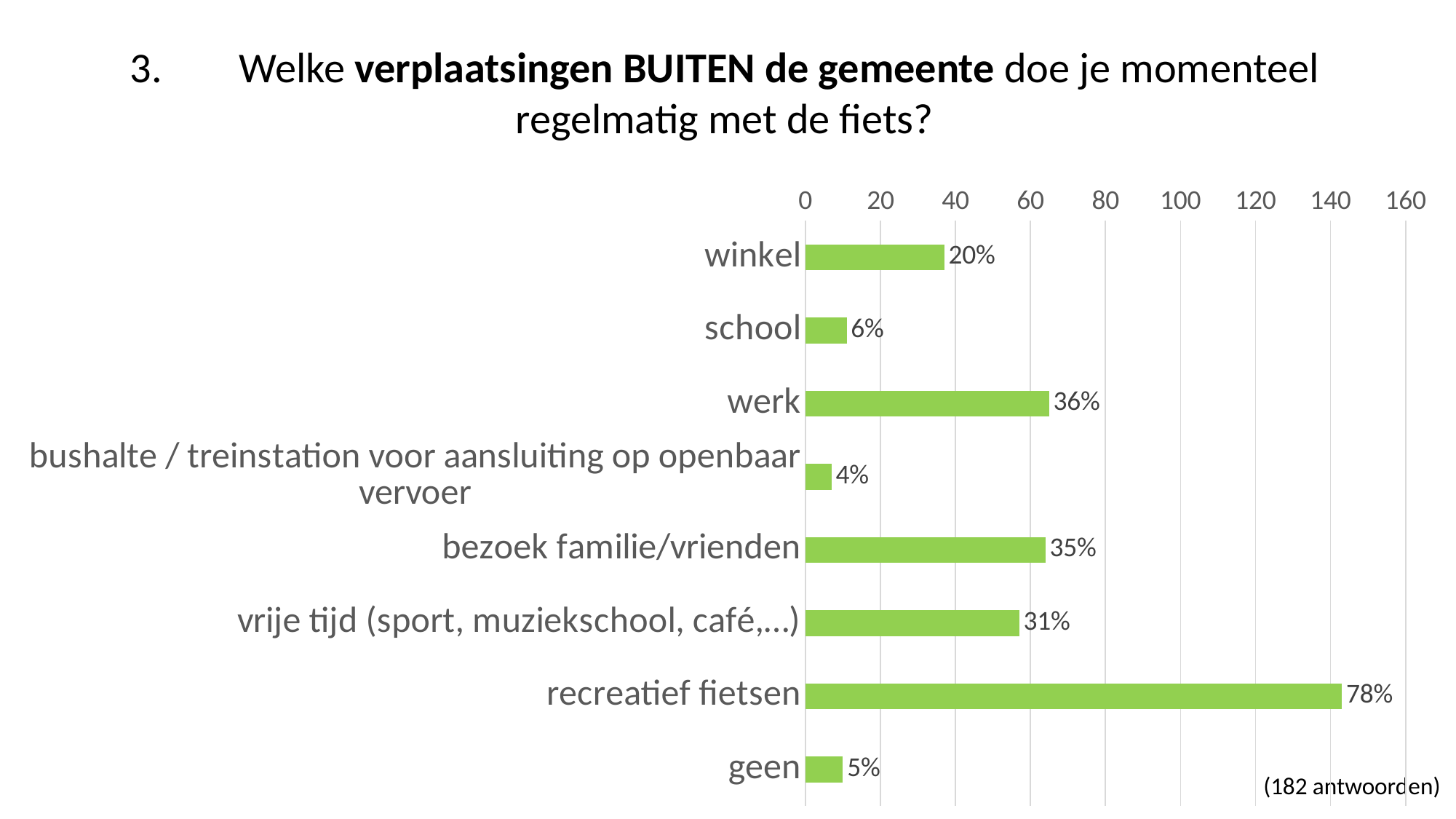
What is the data label for 'school'? 6% How many categories are shown in the chart? 8 Which category has the lowest value? bushalte / treinstation voor aansluiting op openbaar vervoer Is the bar for 'werk' greater or less than 60 on the axis? greater What is the data label for 'werk'? 36% What is the data label for 'recreatief fietsen'? 78% What is the data label for 'bezoek familie/vrienden'? 35% What is the difference in percentage points between 'werk' and 'bezoek familie/vrienden'? 1 Which category has the highest value? recreatief fietsen What kind of chart is shown on the slide? bar chart Which has a larger value, 'winkel' or 'vrije tijd (sport, muziekschool, café,...)'? vrije tijd (sport, muziekschool, café,...) Is the bar for 'winkel' greater or less than 40 on the axis? less